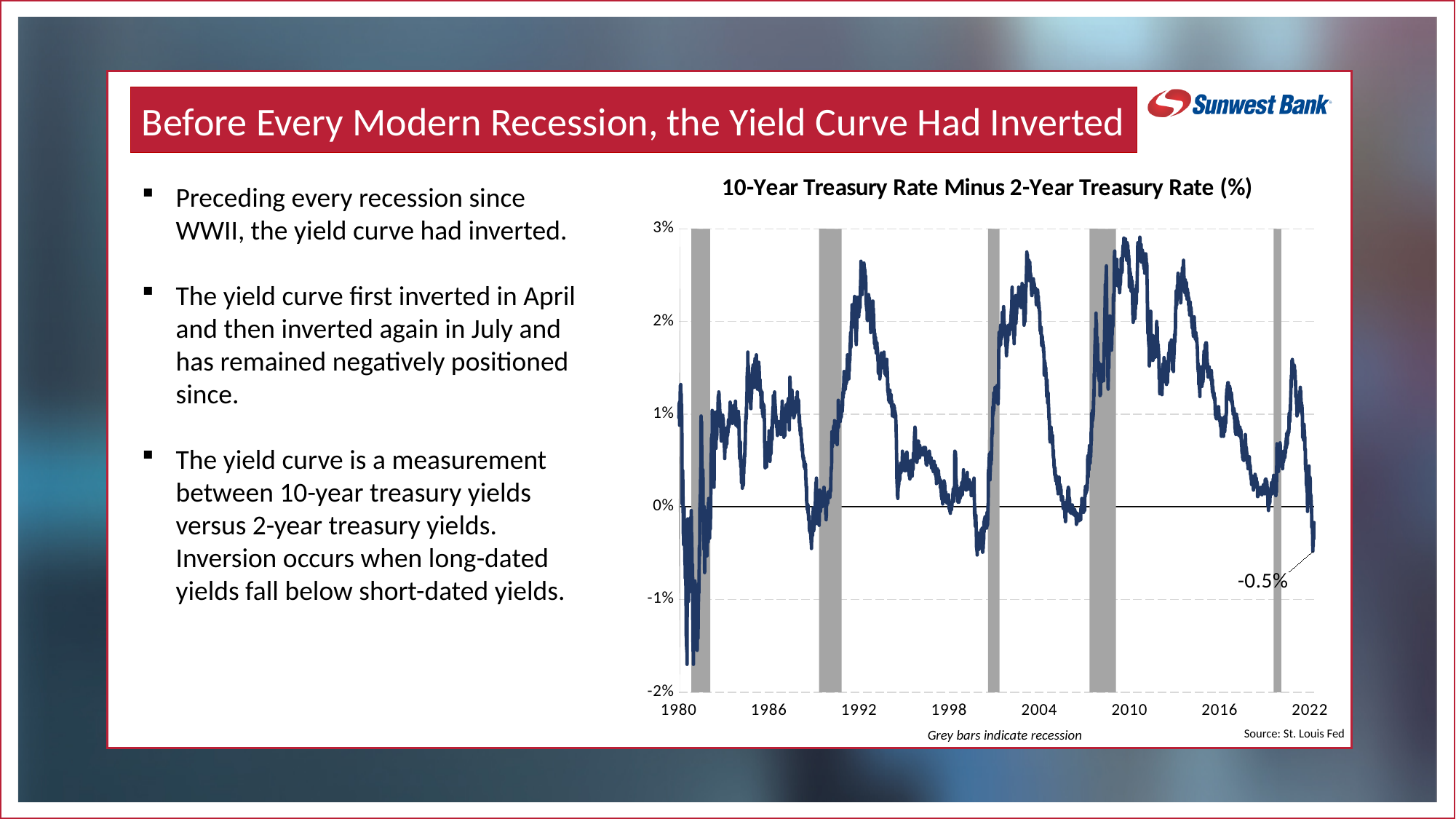
Is the peak value around 1992 greater or less than 2%? greater What is the value labelled at the end of the line in 2022? -0.5% Is the lowest value in the early 1980s greater or less than -1%? less What is the title of the chart? 10-Year Treasury Rate Minus 2-Year Treasury Rate (%) Is the final value in 2022 greater or less than 0%? less What kind of chart is shown on the slide? line chart How many grey recession bars are shown on the chart? 5 How many year labels are shown on the x axis? 8 Overall, does the value rise or fall between its peak around 2010 and 2022? fall According to the chart note, what do the grey bars indicate? recession